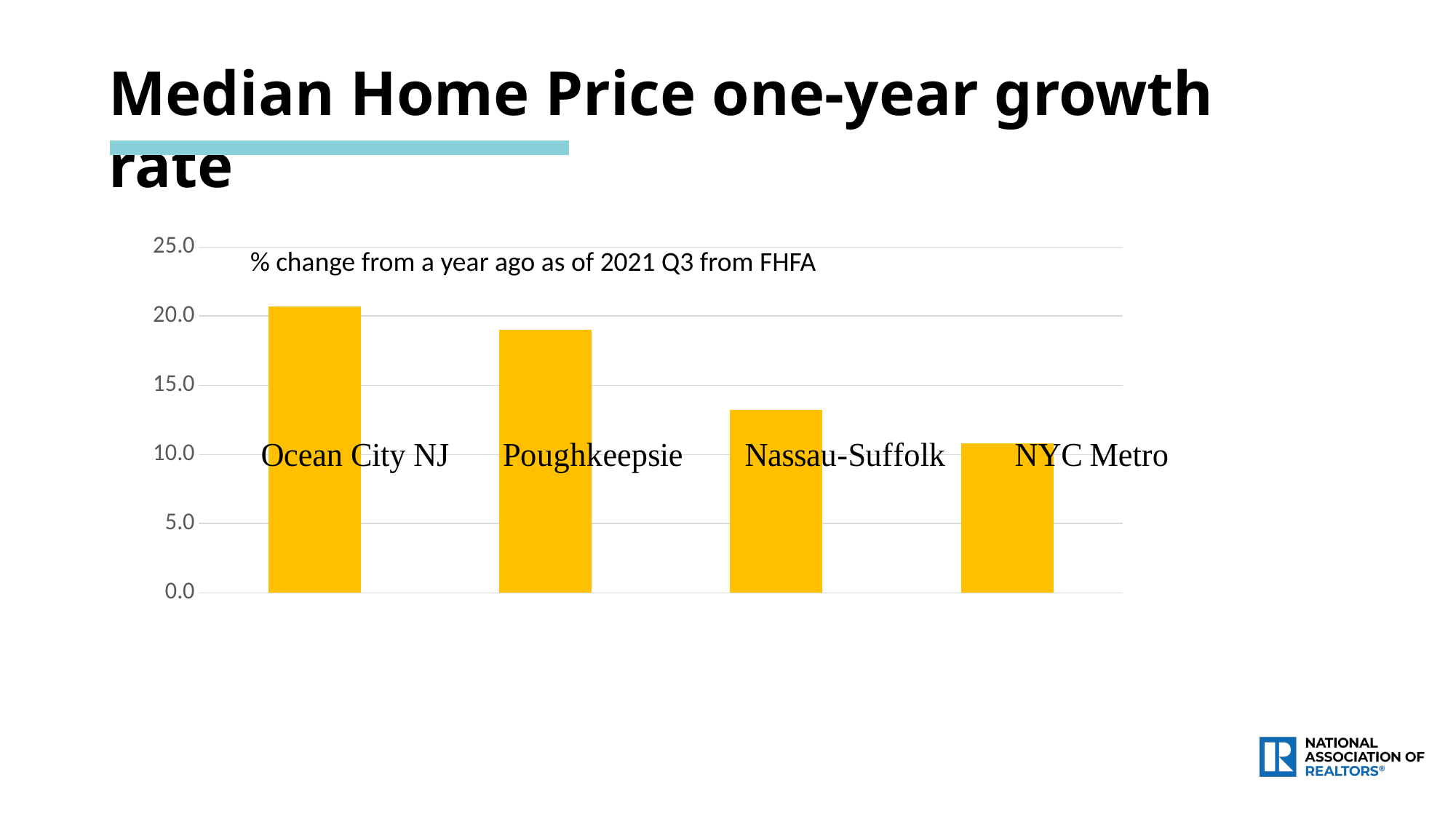
Do the values rise or fall from left to right across the categories? Fall Is the value for Poughkeepsie greater or less than 20.0? less How many categories are shown in the chart? 4 What is the title of the slide? Median Home Price one-year growth rate Which has a larger value, Poughkeepsie or Nassau-Suffolk? Poughkeepsie Which has a larger value, Nassau-Suffolk or NYC Metro? Nassau-Suffolk Is the value for Nassau-Suffolk greater or less than 15.0? less Is the value for NYC Metro greater or less than 10.0? greater What kind of chart is shown on the slide? Bar chart Which category has the lowest value in the chart? NYC Metro Which category has the highest value in the chart? Ocean City NJ